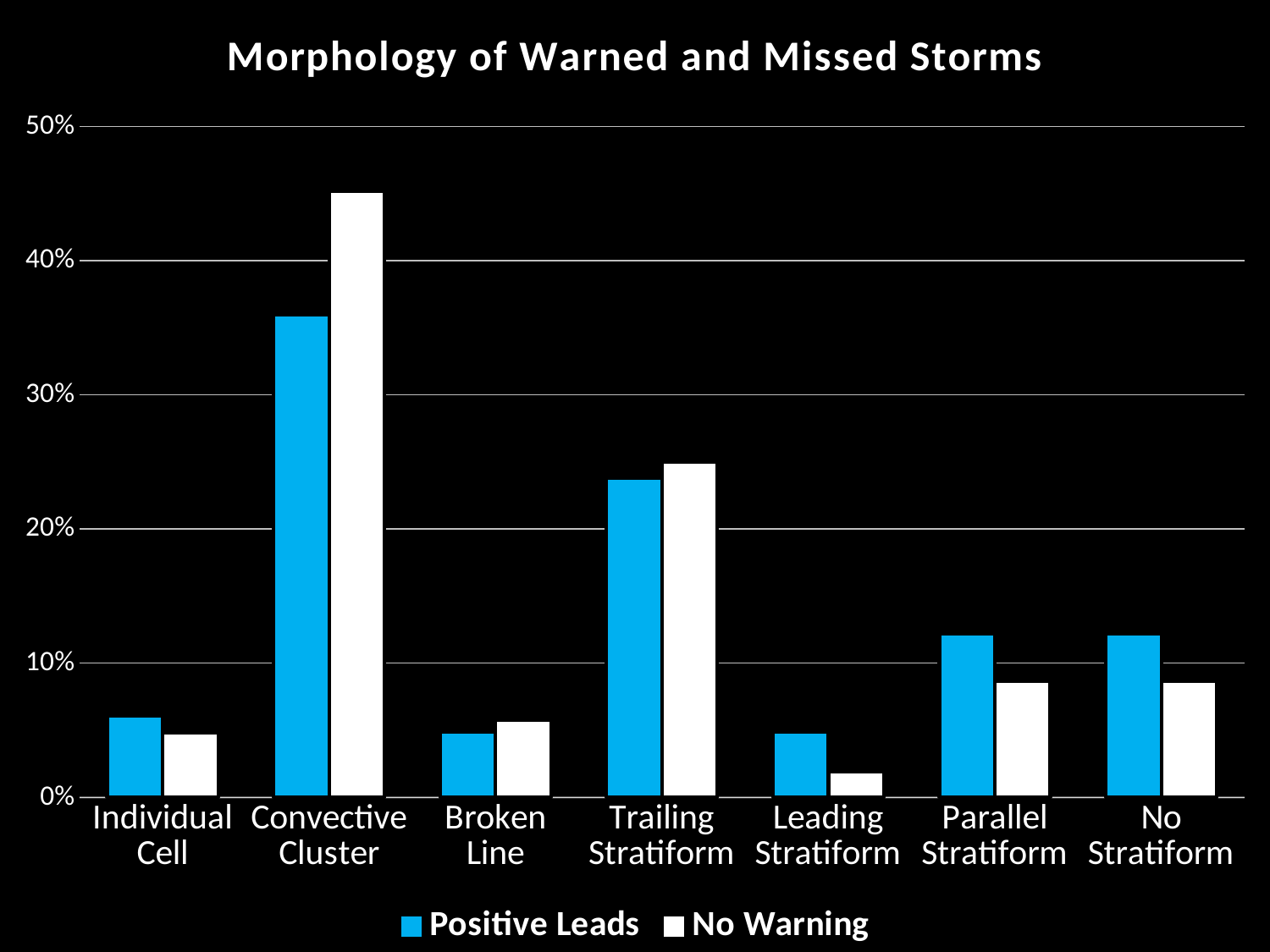
For Convective Cluster, which is larger: Positive Leads or No Warning? No Warning Is the Positive Leads value for Trailing Stratiform greater or less than 20%? greater Which category has the highest Positive Leads value? Convective Cluster What type of chart is shown on the slide? bar chart Is the No Warning value for Convective Cluster greater or less than 40%? greater Is the No Warning value for Parallel Stratiform greater or less than 10%? less Which category has the lowest No Warning value? Leading Stratiform For Leading Stratiform, which is larger: Positive Leads or No Warning? Positive Leads Which category has the highest No Warning value? Convective Cluster How many series does the legend list? 2 How many storm morphology categories are shown on the x axis? 7